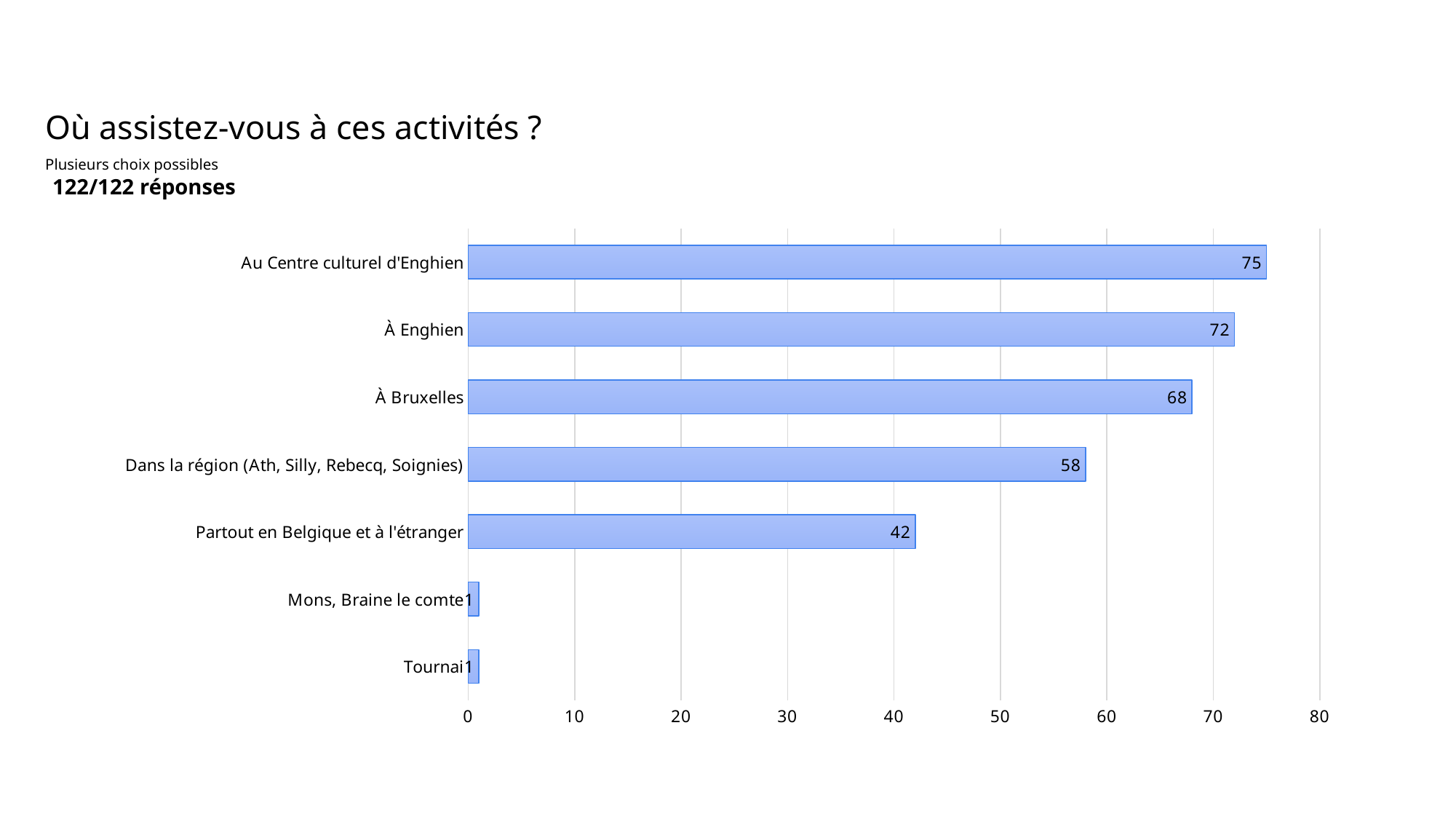
What is the value for "Dans la région (Ath, Silly, Rebecq, Soignies)"? 58 What kind of chart is shown on the slide? bar chart What is the value for "Au Centre culturel d'Enghien"? 75 Which is larger, the value for "À Bruxelles" or the value for "Dans la région (Ath, Silly, Rebecq, Soignies)"? À Bruxelles What is the title of the chart? Où assistez-vous à ces activités ? Is the value for "Partout en Belgique et à l'étranger" greater or less than 50? less How many categories are shown in the chart? 7 What is the value for "À Bruxelles"? 68 What is the value for "Partout en Belgique et à l'étranger"? 42 Which category has the highest value? Au Centre culturel d'Enghien What is the difference between the values for "À Enghien" and "À Bruxelles"? 4 What is the difference between the values for "Au Centre culturel d'Enghien" and "Partout en Belgique et à l'étranger"? 33